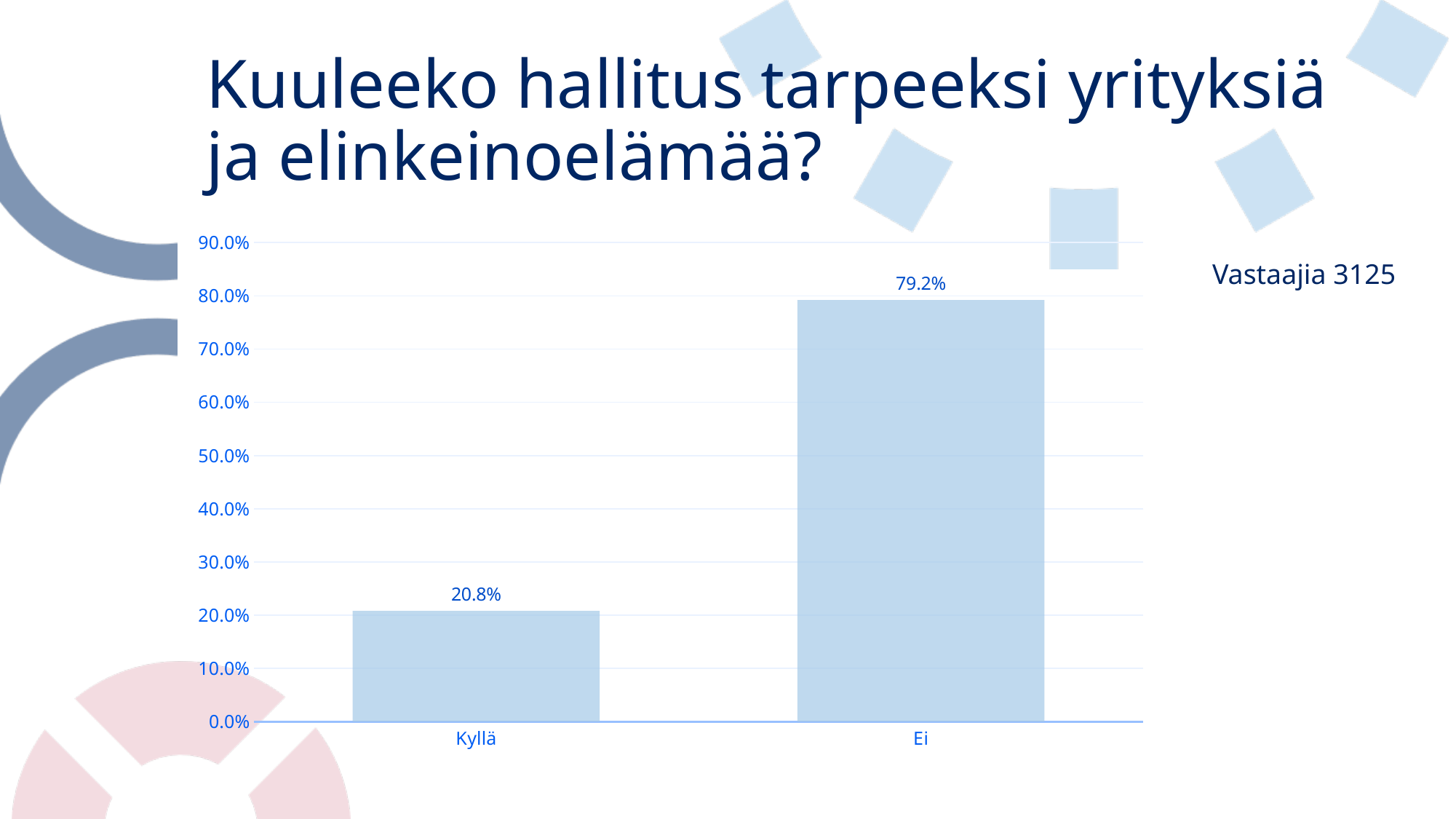
Which category has the lowest value? Kyllä What kind of chart is shown on the slide? bar chart Which category has the highest value? Ei What is the value for Kyllä? 20.8% What is the difference between the values for Ei and Kyllä? 58.4% How many categories are shown on the x axis? 2 What is the value for Ei? 79.2% Is the value for Kyllä greater or less than 30.0%? less Is the value for Ei greater or less than 70.0%? greater What is the highest value shown on the y axis? 90.0% Which is larger, the value for Kyllä or the value for Ei? Ei How many respondents (Vastaajia) does the slide state? 3125